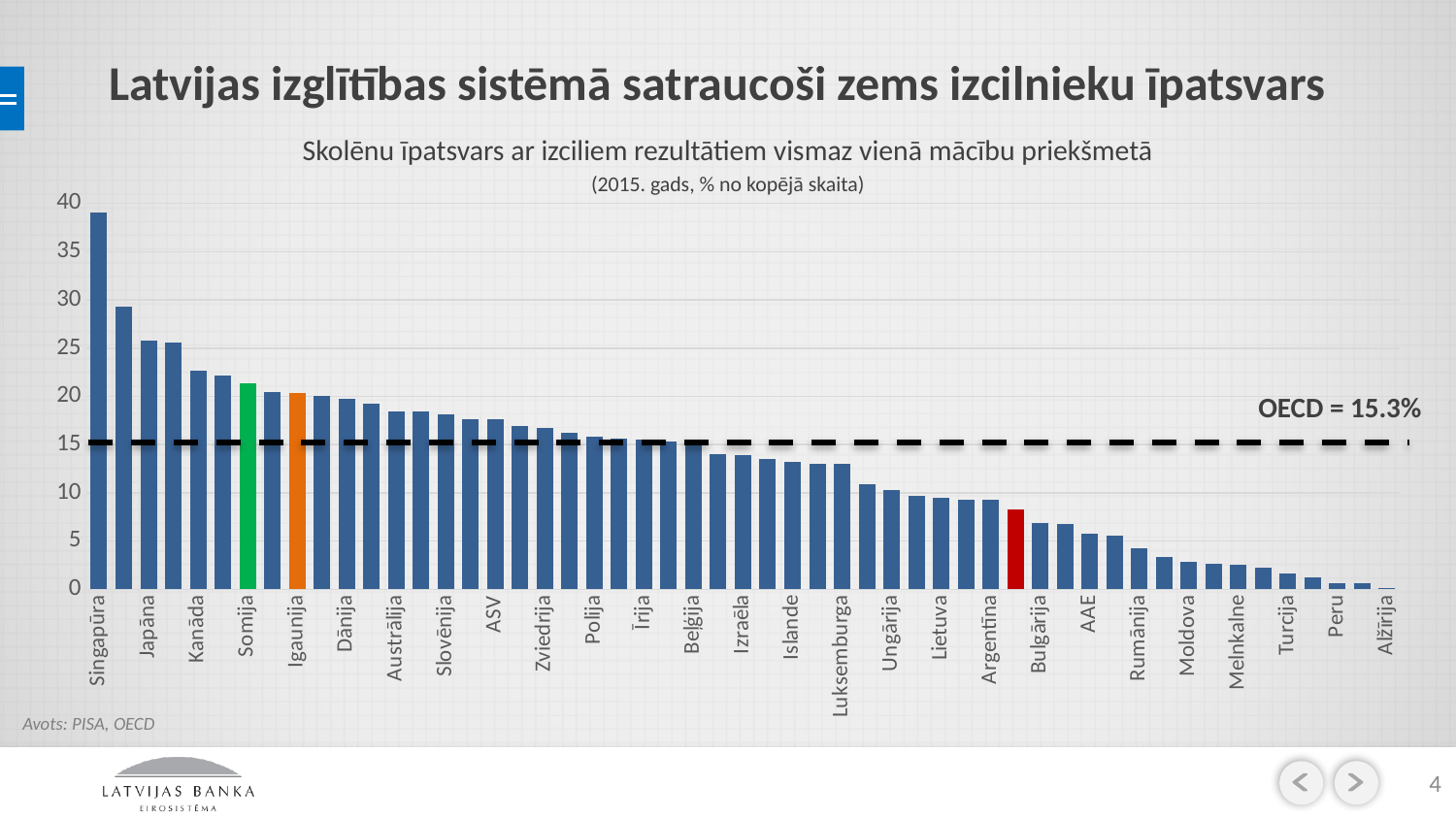
Which country has the highest share of students with excellent results? Singapūra Do the values rise or fall moving from left to right along the x axis? fall What kind of chart is shown on the slide? bar chart Is the value for Singapūra greater or less than 35? greater Is the value for Lietuva greater or less than 10? less What colour is the bar for Somija? green Is the value for Japāna greater or less than 25? greater Which labelled country has the lowest value in the chart? Alžīrija What is the OECD average value shown on the chart? 15.3% Which has a larger value, Japāna or Kanāda? Japāna